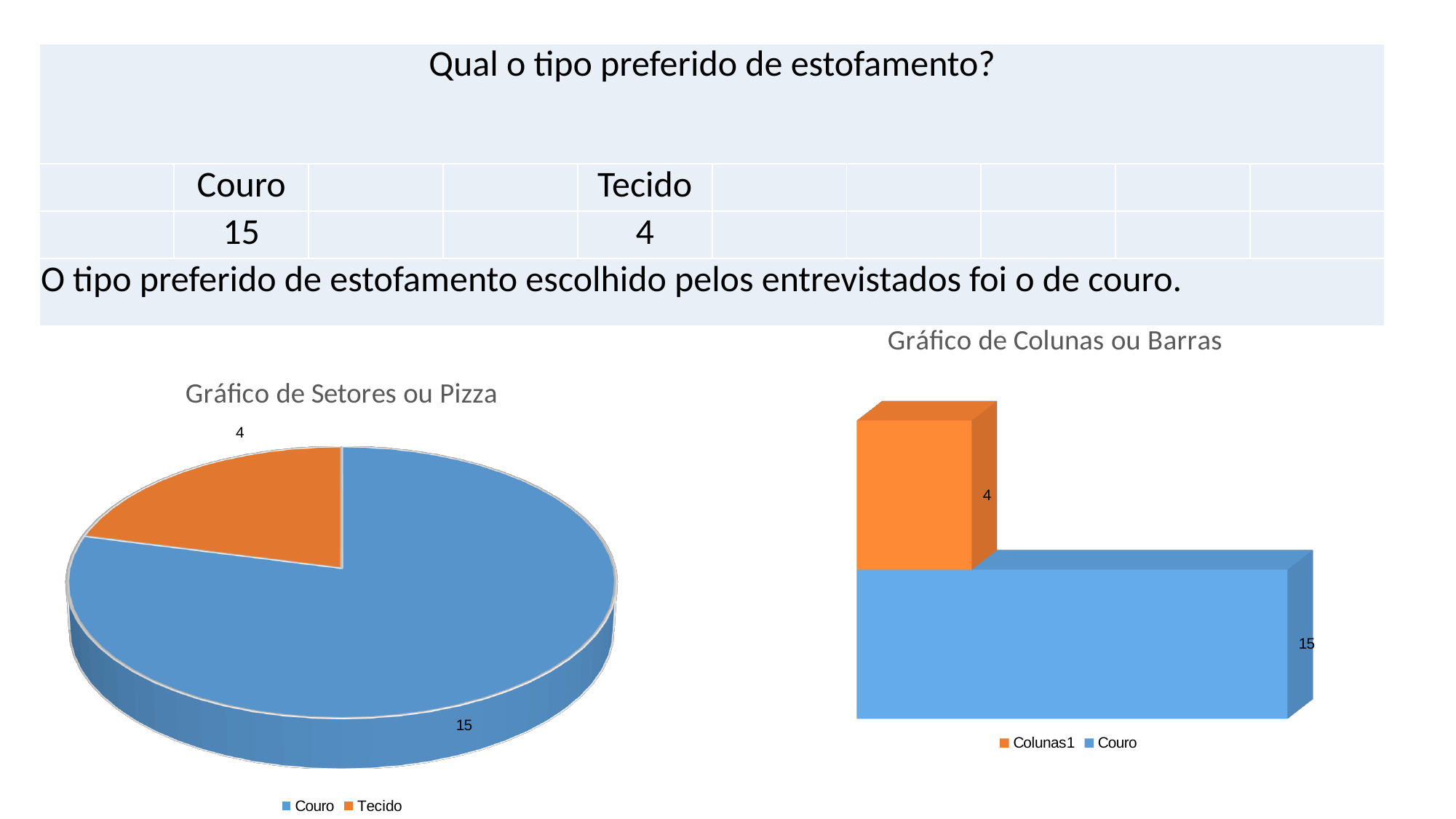
In the chart titled 'Gráfico de Setores ou Pizza', which category has the smallest slice? Tecido In the chart titled 'Gráfico de Colunas ou Barras', what is the value for Couro? 15 In the chart titled 'Gráfico de Colunas ou Barras', what is the value for Colunas1? 4 In the chart titled 'Gráfico de Setores ou Pizza', what is the value for Couro? 15 How many series does the legend of the chart titled 'Gráfico de Colunas ou Barras' list? 2 In the chart titled 'Gráfico de Setores ou Pizza', what is the value for Tecido? 4 What kind of chart is the one titled 'Gráfico de Colunas ou Barras'? Bar chart In the chart titled 'Gráfico de Colunas ou Barras', which series has the larger value, Couro or Colunas1? Couro In the chart titled 'Gráfico de Setores ou Pizza', what is the difference between the values for Couro and Tecido? 11 What kind of chart is the one titled 'Gráfico de Setores ou Pizza'? Pie chart In the chart titled 'Gráfico de Setores ou Pizza', which category has the largest slice? Couro How many categories does the legend of the chart titled 'Gráfico de Setores ou Pizza' list? 2